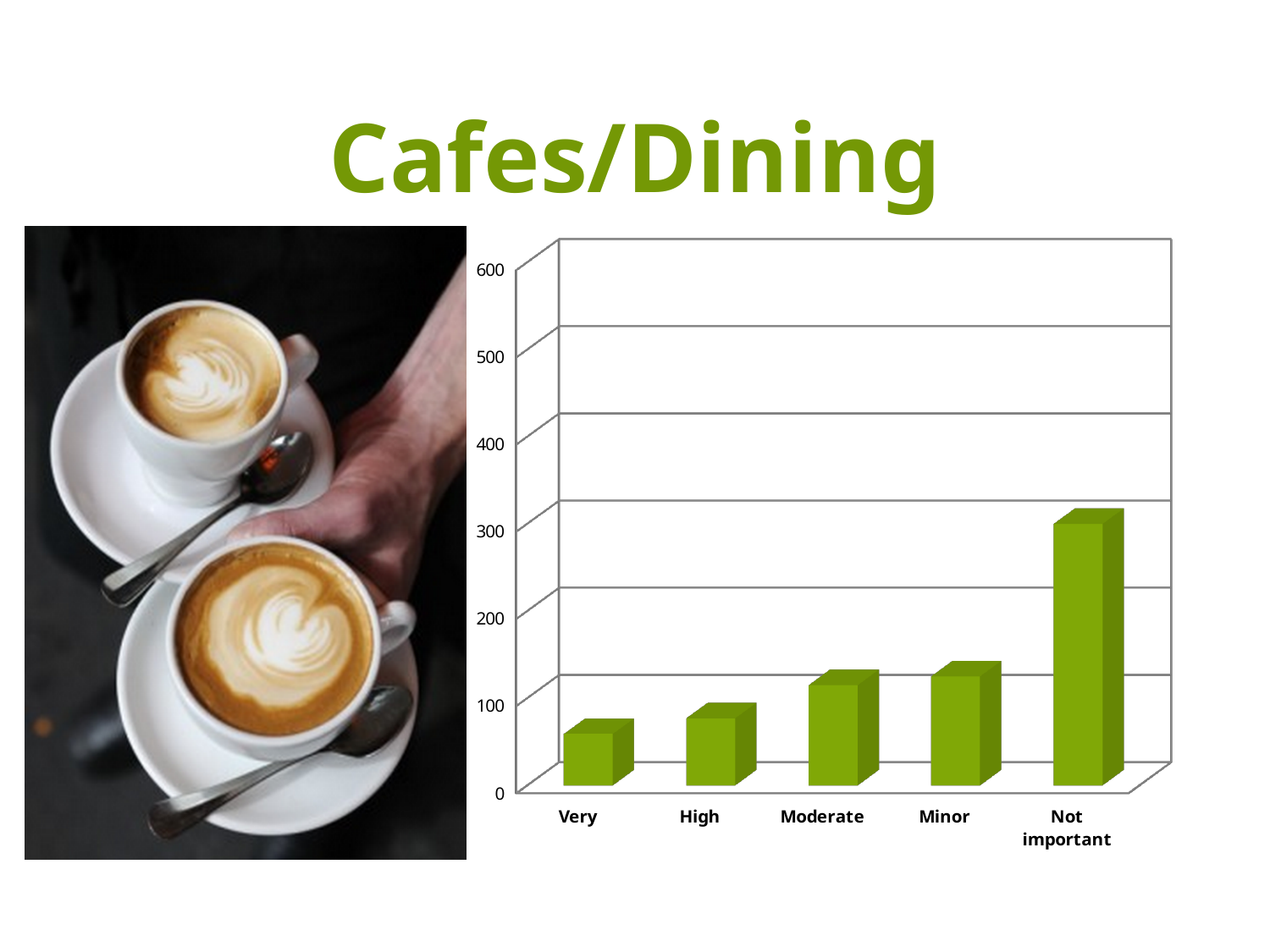
What kind of chart is shown on the slide? bar chart Which category has the lowest bar in the chart? Very Which category has the highest bar in the chart? Not important Which is larger, the value for Moderate or the value for Very? Moderate How many categories are shown on the x axis of the chart? 5 Do the bar values rise or fall moving from Very to Not important along the x axis? rise Is the value for Not important greater or less than 400? less What is the title of the slide containing the chart? Cafes/Dining Is the value for High greater or less than 100? less Which is larger, the value for Not important or the value for Minor? Not important Is the value for Very greater or less than 100? less